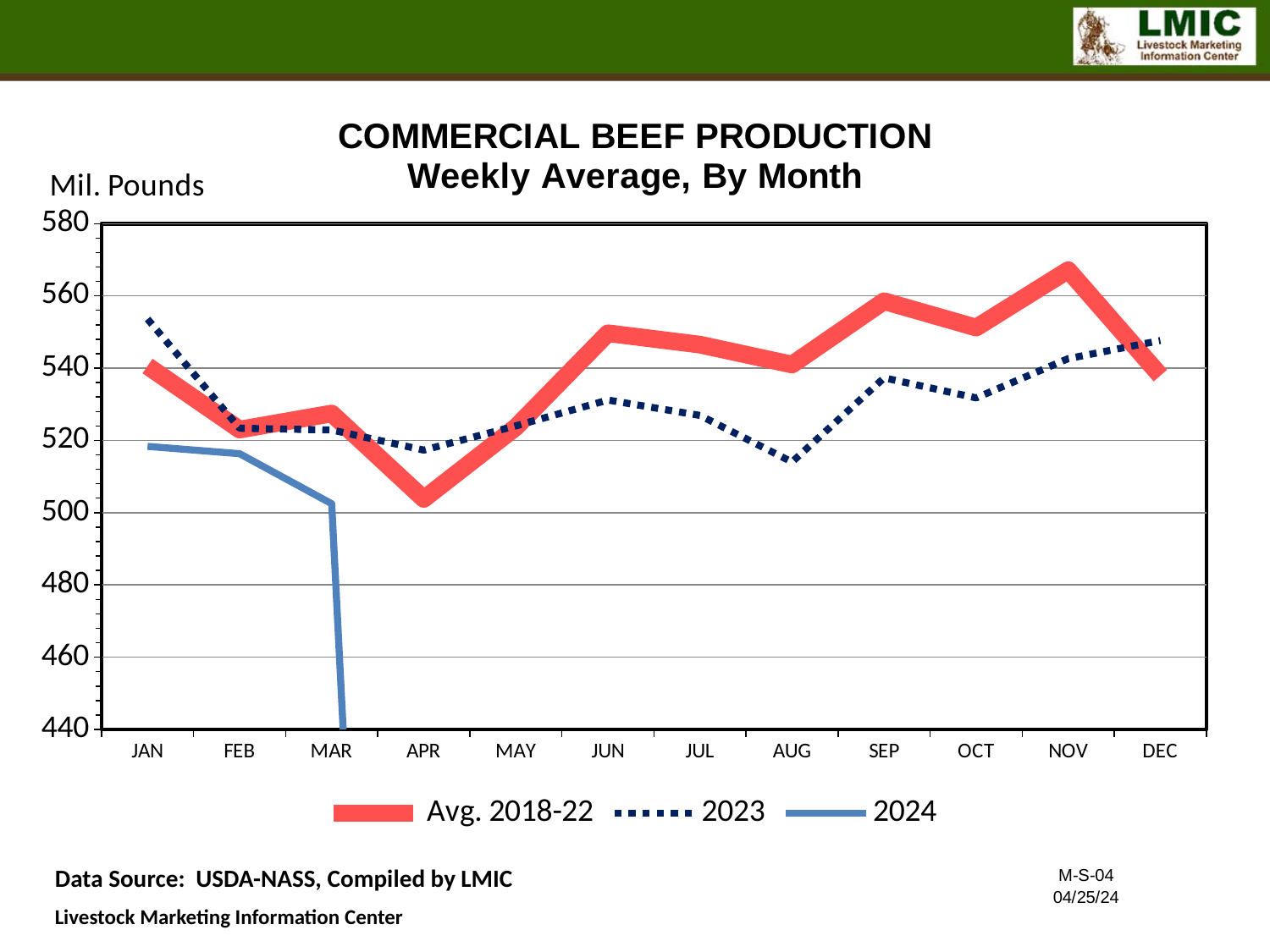
Does the 2024 series rise or fall from JAN to MAR? Fall Is the 2023 value for JAN greater or less than 540? greater Is the Avg. 2018-22 value for APR greater or less than 520? less How many series does the legend list? 3 In which month does the Avg. 2018-22 series reach its highest value? NOV What kind of chart is shown on the slide? Line chart In which month does the Avg. 2018-22 series reach its lowest value? APR In which month does the 2023 series reach its highest value? JAN In JAN, which series is higher: 2023 or Avg. 2018-22? 2023 How many months are shown along the x axis? 12 What unit is shown on the y axis? Mil. Pounds Is the 2024 value for MAR greater or less than 520? less